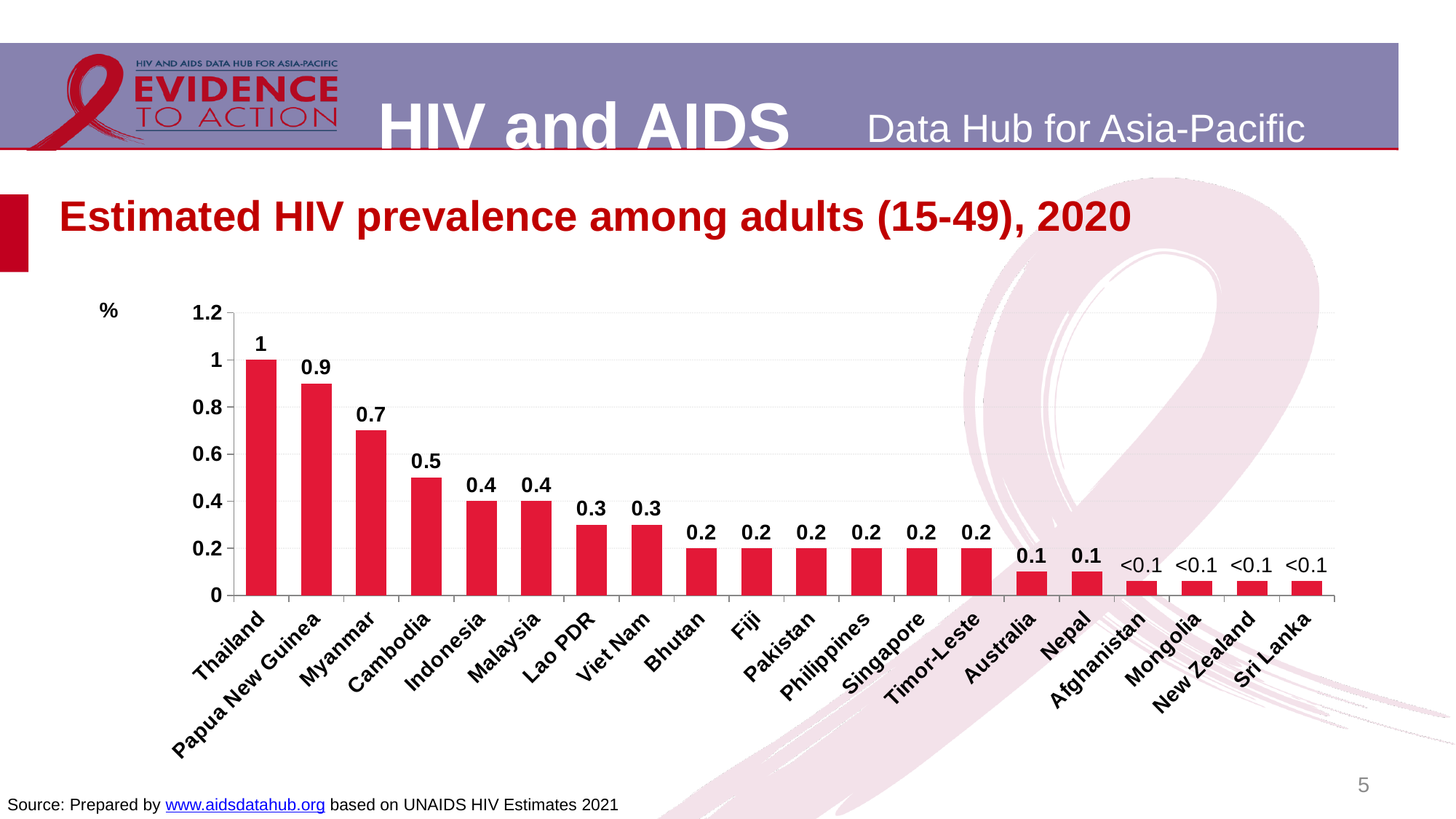
How many countries are shown on the chart? 20 Which has a higher estimated HIV prevalence, Lao PDR or Australia? Lao PDR What is the estimated HIV prevalence among adults (15-49) in Thailand? 1 What kind of chart is used to show estimated HIV prevalence among adults? Bar chart What is the difference between the values for Papua New Guinea and Cambodia? 0.4 Do the values rise or fall moving from left to right along the x axis? Fall Which has a higher estimated HIV prevalence, Myanmar or Indonesia? Myanmar What is the estimated HIV prevalence among adults (15-49) in Cambodia? 0.5 What is the difference between the values for Thailand and Myanmar? 0.3 What value is shown for Sri Lanka? <0.1 Which country has the highest estimated HIV prevalence among adults (15-49) in 2020? Thailand What is the estimated HIV prevalence among adults (15-49) in Papua New Guinea? 0.9